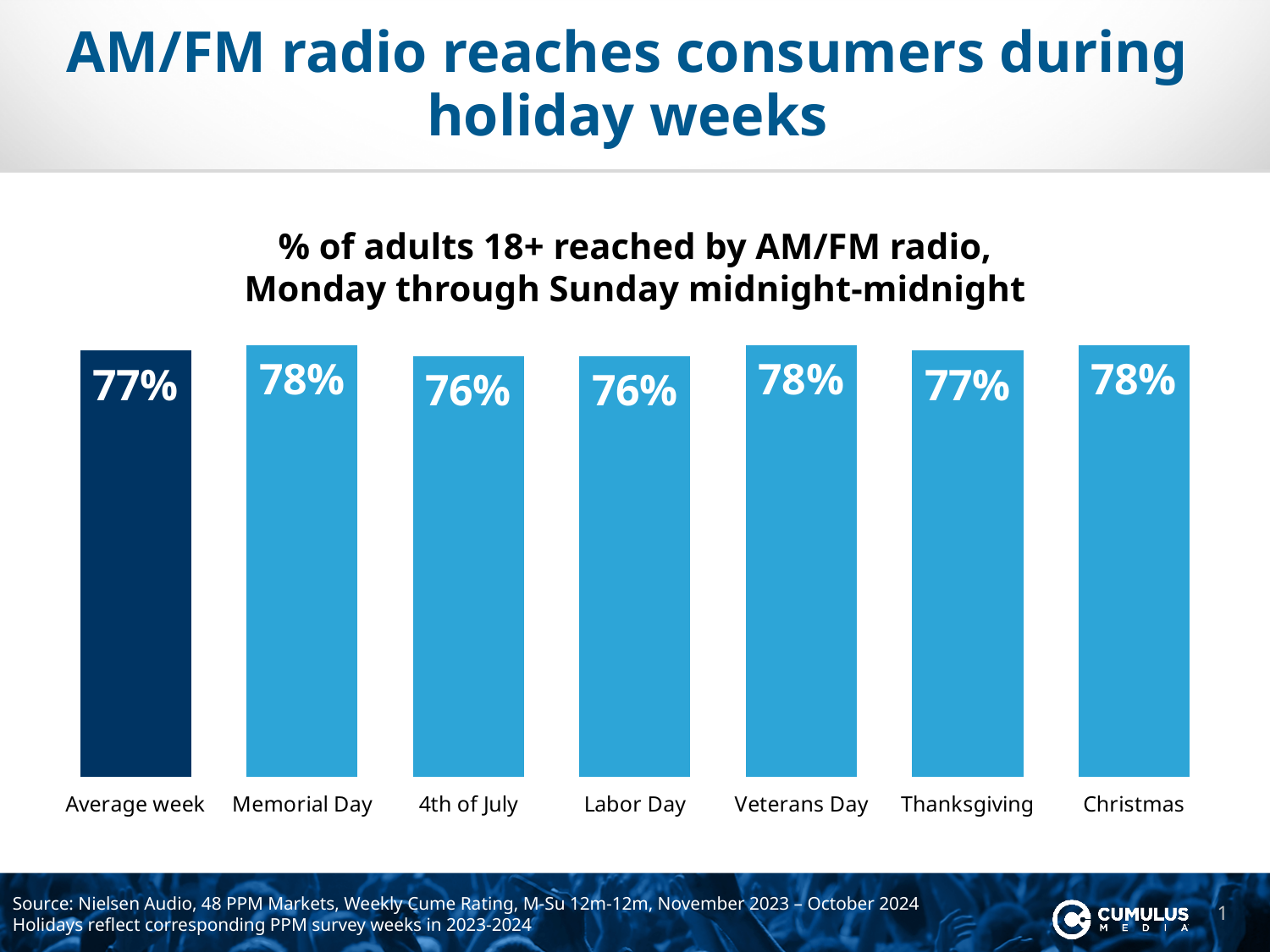
What is the value shown for 4th of July? 76% What is the value shown for Memorial Day? 78% What is the value shown for Christmas? 78% What is the difference between the values for Memorial Day and Labor Day? 2 percentage points How many categories are shown on the chart? 7 What is the lowest value shown on the chart? 76% What is the value shown for Thanksgiving? 77% What percentage of adults 18+ is reached by AM/FM radio during the Average week? 77% Which has a higher value, Veterans Day or 4th of July? Veterans Day Which bar is shown in a darker colour than the others? Average week What kind of chart is shown on the slide? Bar chart What is the highest value shown on the chart? 78%